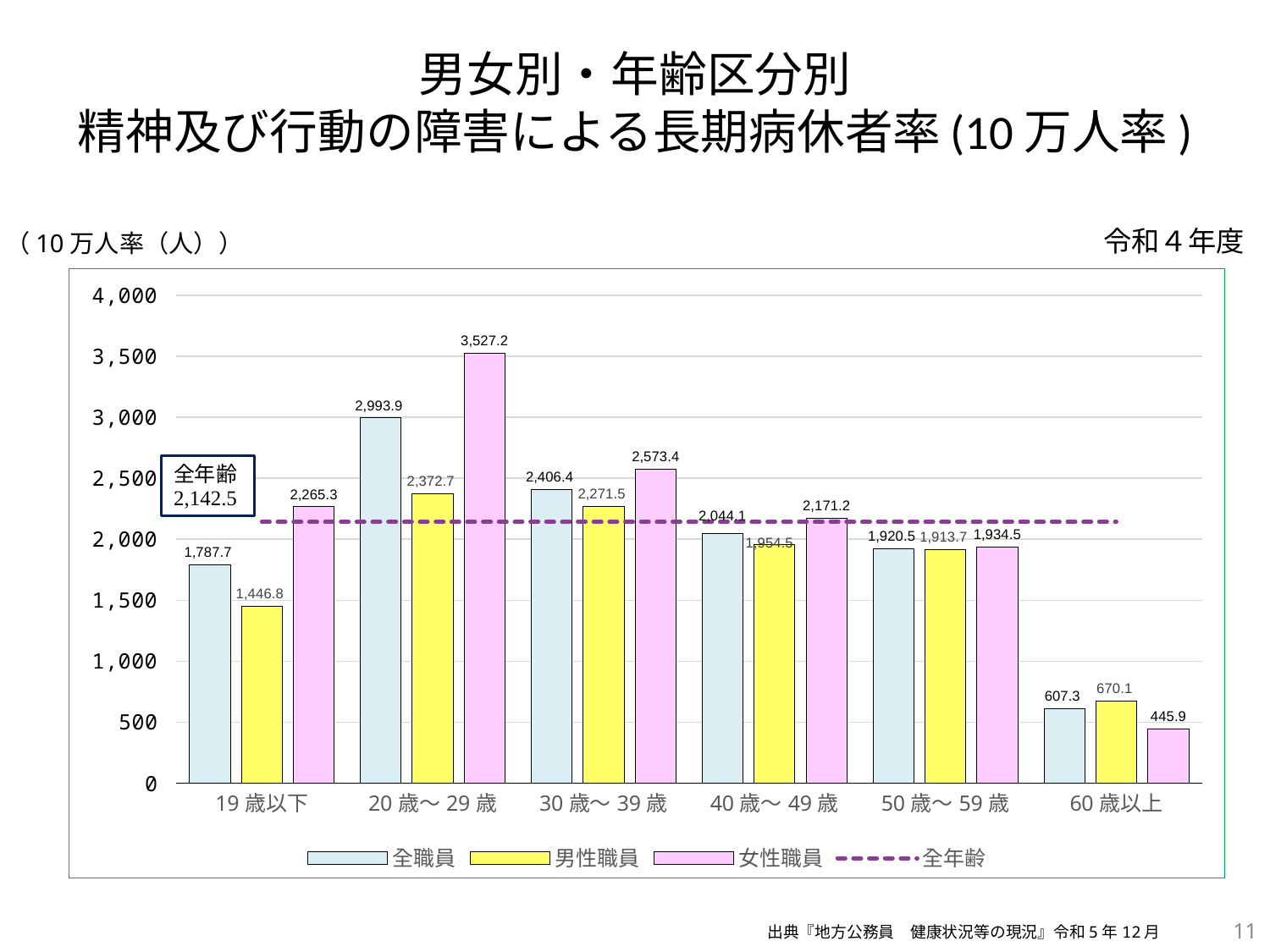
How many entries does the legend list? 4 What kind of chart is shown on the slide? bar chart Is the value for 全職員 in the 30歳～39歳 age group greater or less than 2,000? greater Which age group has the lowest value for 女性職員? 60歳以上 How many age groups are shown on the x axis? 6 What is the value for 全職員 in the 60歳以上 age group? 607.3 In the 60歳以上 age group, which is larger, the value for 男性職員 or for 女性職員? 男性職員 Which age group has the highest value for 全職員? 20歳～29歳 What is the value for 女性職員 in the 20歳～29歳 age group? 3,527.2 What is the difference between the 女性職員 and 男性職員 values in the 20歳～29歳 age group? 1,154.5 What is the value for 男性職員 in the 19歳以下 age group? 1,446.8 What is the 全年齢 value shown by the dashed line? 2,142.5